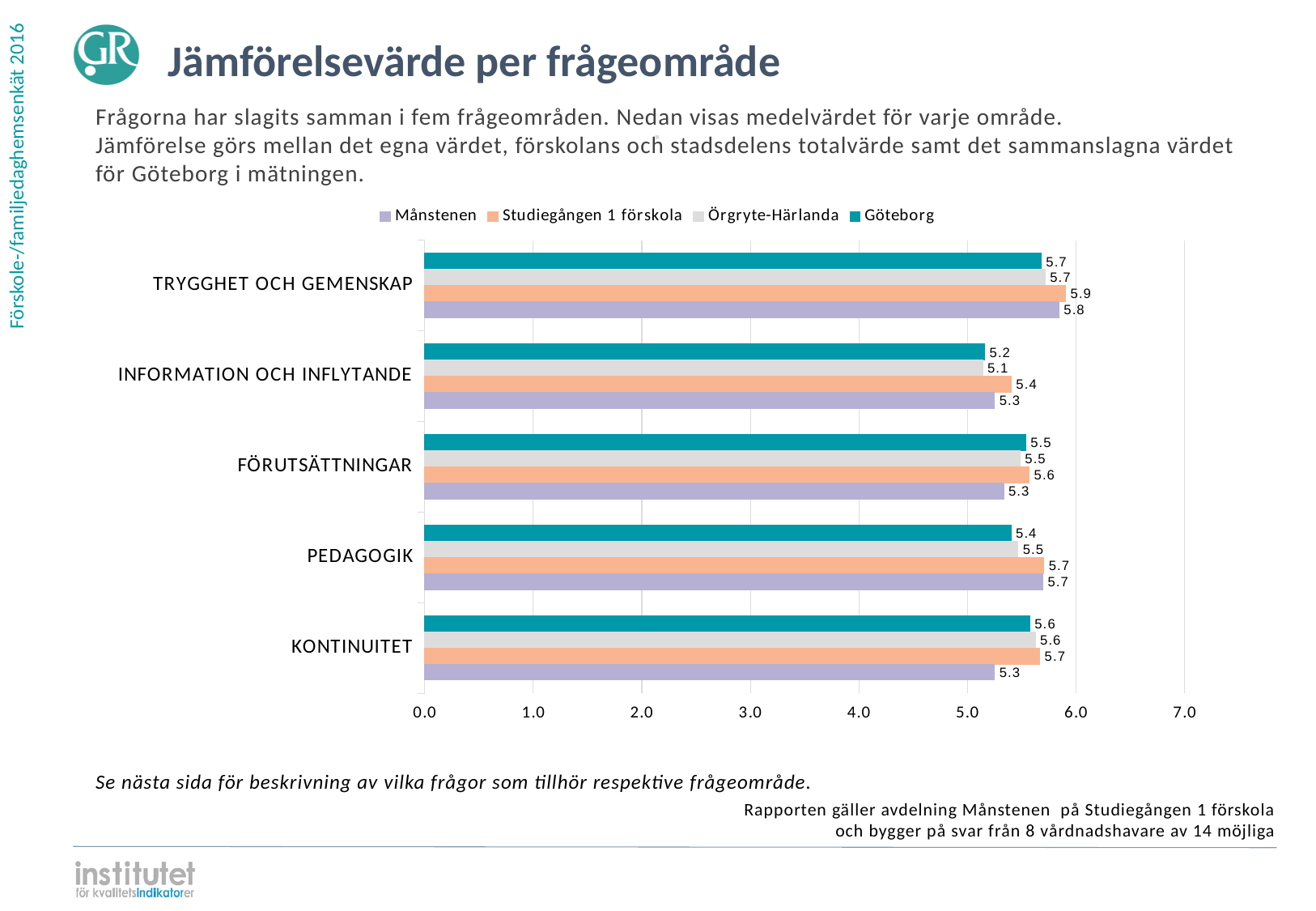
What is the value for Örgryte-Härlanda in the KONTINUITET category? 5.6 What is the difference between the Studiegången 1 förskola value and the Månstenen value in the KONTINUITET category? 0.4 What is the value for Göteborg in the PEDAGOGIK category? 5.4 Which series is shown in teal on the chart? Göteborg What is the value for Månstenen in the TRYGGHET OCH GEMENSKAP category? 5.8 In which category does Månstenen have its highest value? TRYGGHET OCH GEMENSKAP In the FÖRUTSÄTTNINGAR category, which is larger: the value for Studiegången 1 förskola or the value for Månstenen? Studiegången 1 förskola How many series does the legend list? 4 How many categories are shown on the chart? 5 In which category does Göteborg have its lowest value? INFORMATION OCH INFLYTANDE What is the value for Studiegången 1 förskola in the INFORMATION OCH INFLYTANDE category? 5.4 What kind of chart is shown on the slide? Bar chart